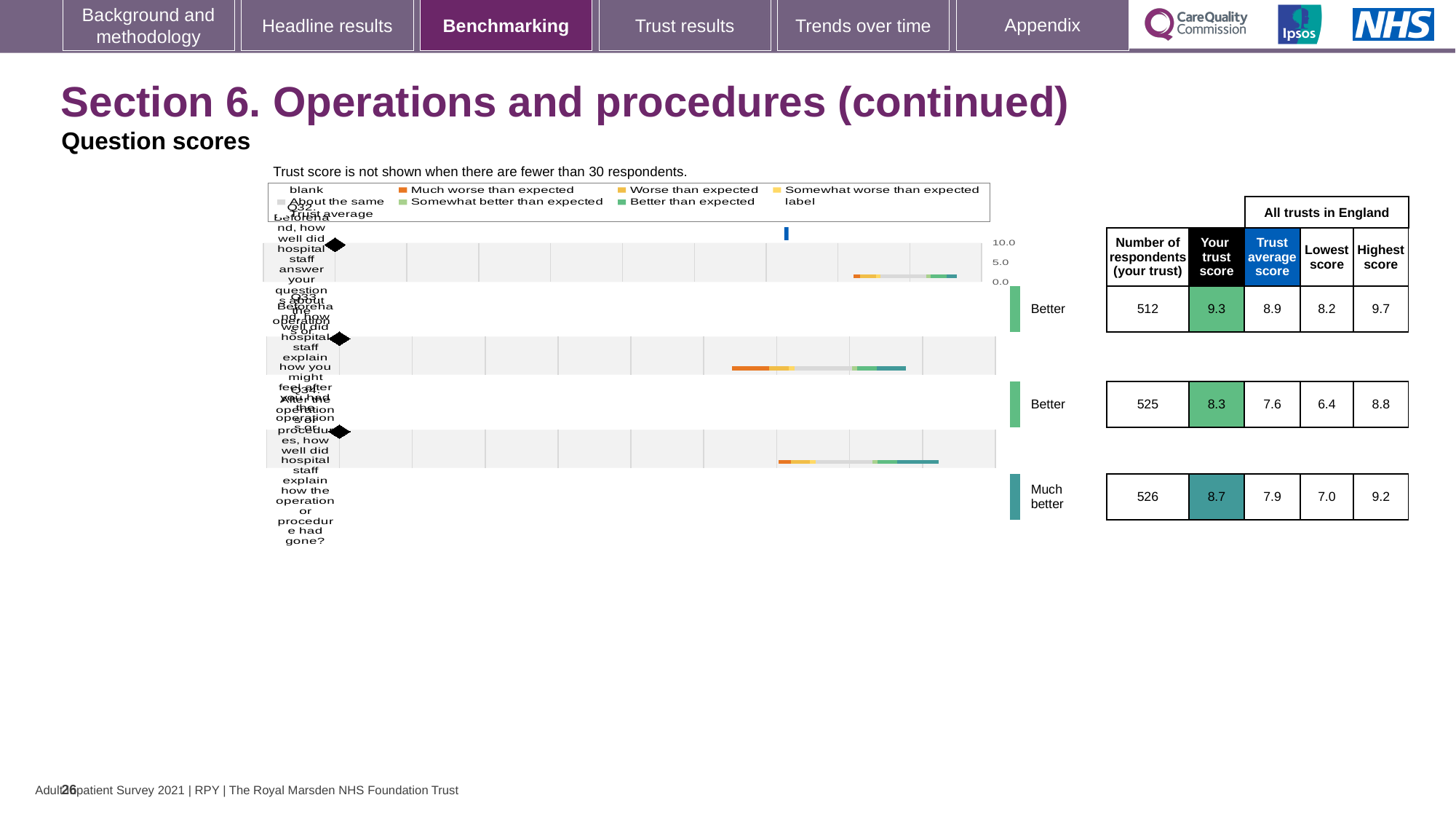
For the third question row (Q34), what is the difference between 'Your trust score' and the 'Trust average score'? 0.8 What is the 'Your trust score' for the first question row (Q32) in the benchmarking chart? 9.3 How many respondents are shown for the third question row (Q34)? 526 Which question row has the highest 'Your trust score'? The first row (Q32), 9.3 For the second question row (Q33), which is larger: 'Your trust score' or the 'Trust average score'? Your trust score How many question rows are plotted in the benchmarking chart? 3 What is the 'Trust average score' for the first question row (Q32)? 8.9 For the first question row (Q32), how much higher is 'Your trust score' than the 'Trust average score'? 0.4 What is the 'Lowest score' for the third question row (Q34)? 7.0 What rating label is shown next to the third question row (Q34)? Much better What is the 'Highest score' for the second question row (Q33)? 8.8 Which question row has the lowest 'Trust average score'? The second row (Q33), 7.6